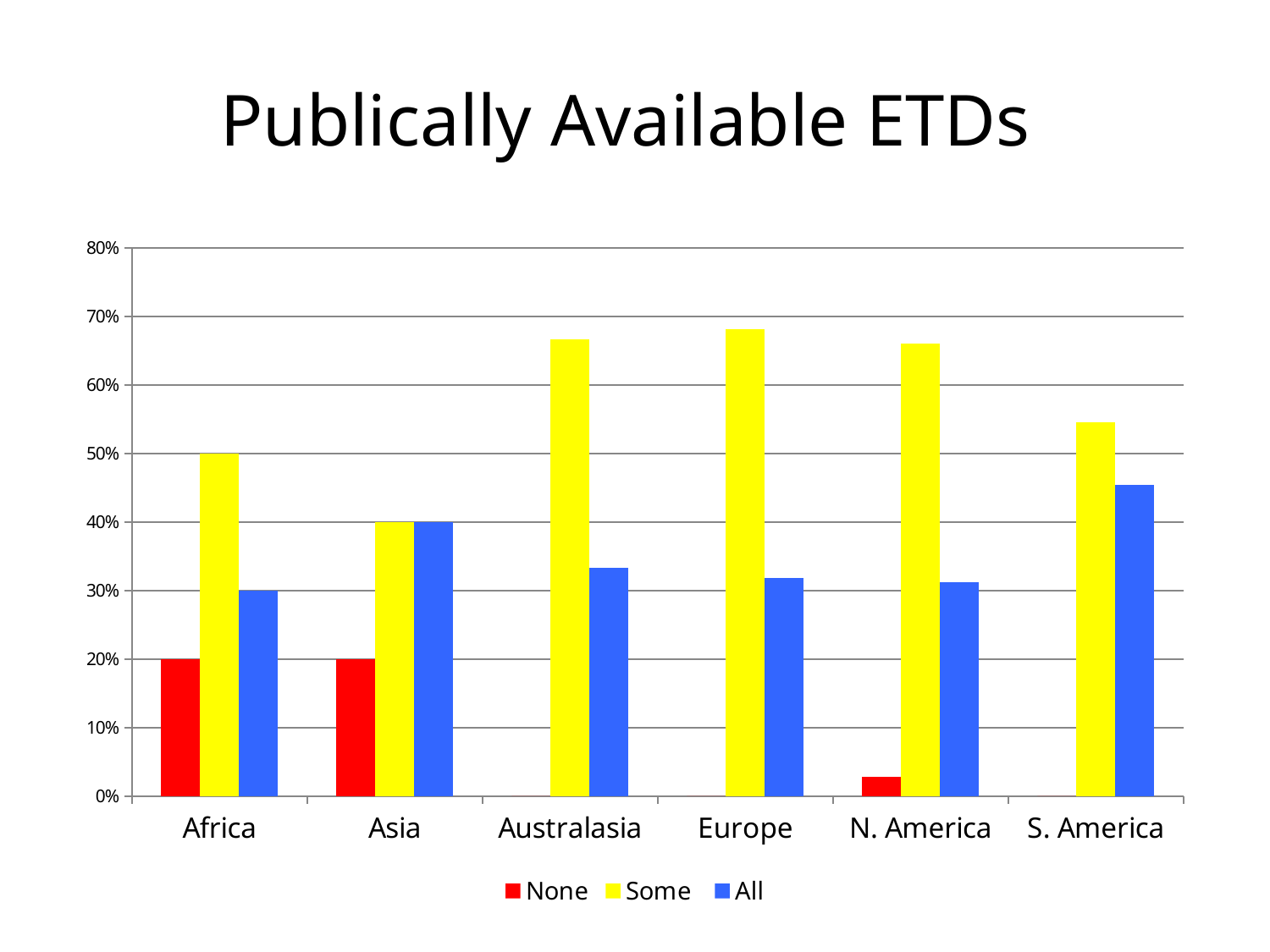
How many regions are shown on the x axis? 6 Which region has the highest value for Some? Europe Which region has the lowest value for Some? Asia What is the value for Some in Africa? 50% Is the value for Some in Australasia greater or less than 60%? greater How many series does the legend list? 3 Is the value for All in S. America greater or less than 40%? greater What is the difference between the Some and All values for Africa? 20% What is the value for None in Asia? 20% What is the value for All in Africa? 30% What type of chart is shown on the slide? bar chart Which is larger, the All value for S. America or the All value for Europe? S. America